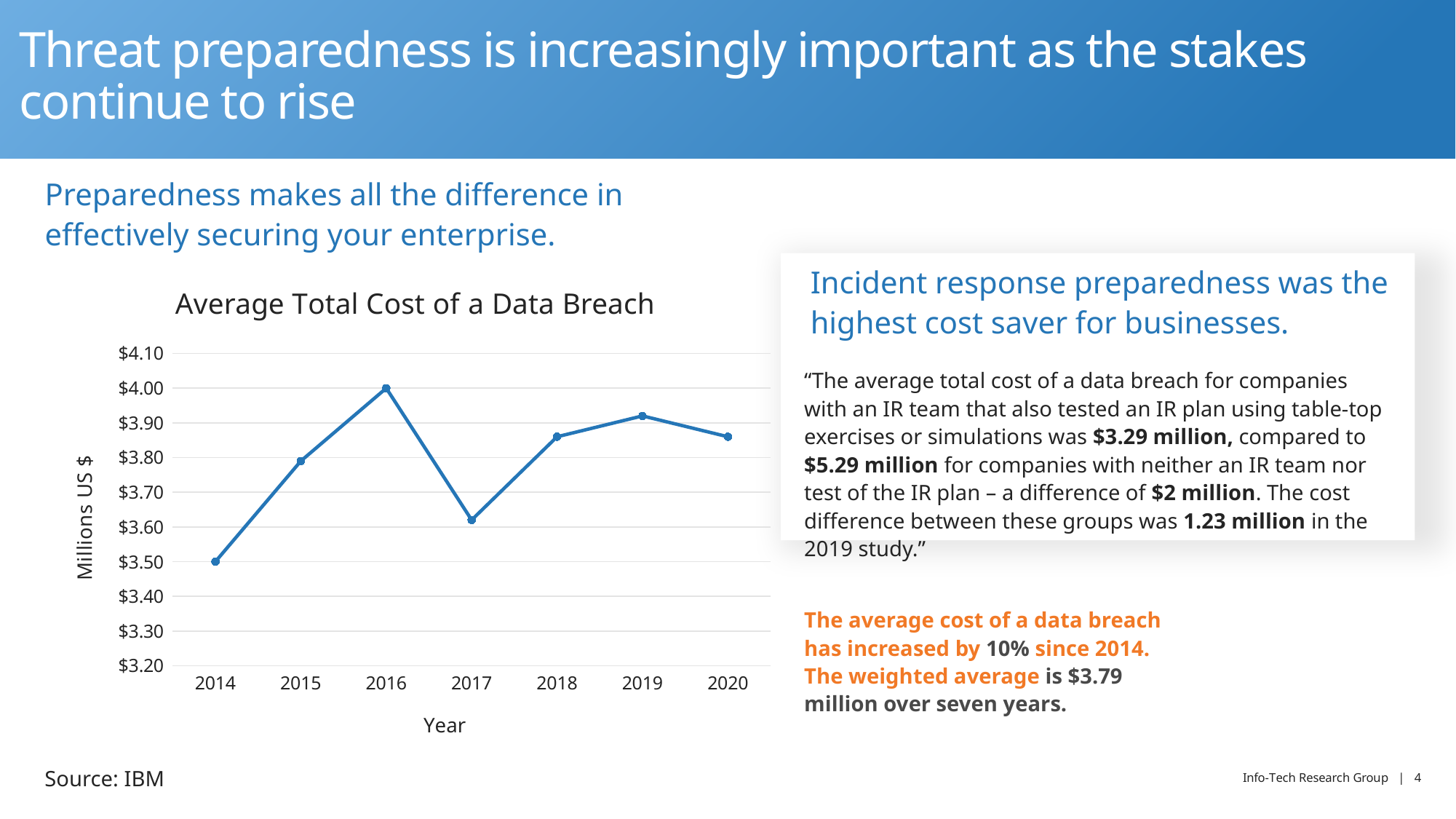
Is the value for 2017 greater or less than $3.70? less How many years are plotted on the chart? 7 Which year has a higher average total cost of a data breach, 2015 or 2017? 2015 Does the average total cost of a data breach rise or fall from 2014 to 2016? Rise What is the average total cost of a data breach for 2016? $4.00 What is the average total cost of a data breach for 2014? $3.50 What is the label of the vertical axis of the chart? Millions US $ Which year has the highest average total cost of a data breach? 2016 What type of chart is shown on the slide? Line chart What is the title of the chart? Average Total Cost of a Data Breach Which year has the lowest average total cost of a data breach? 2014